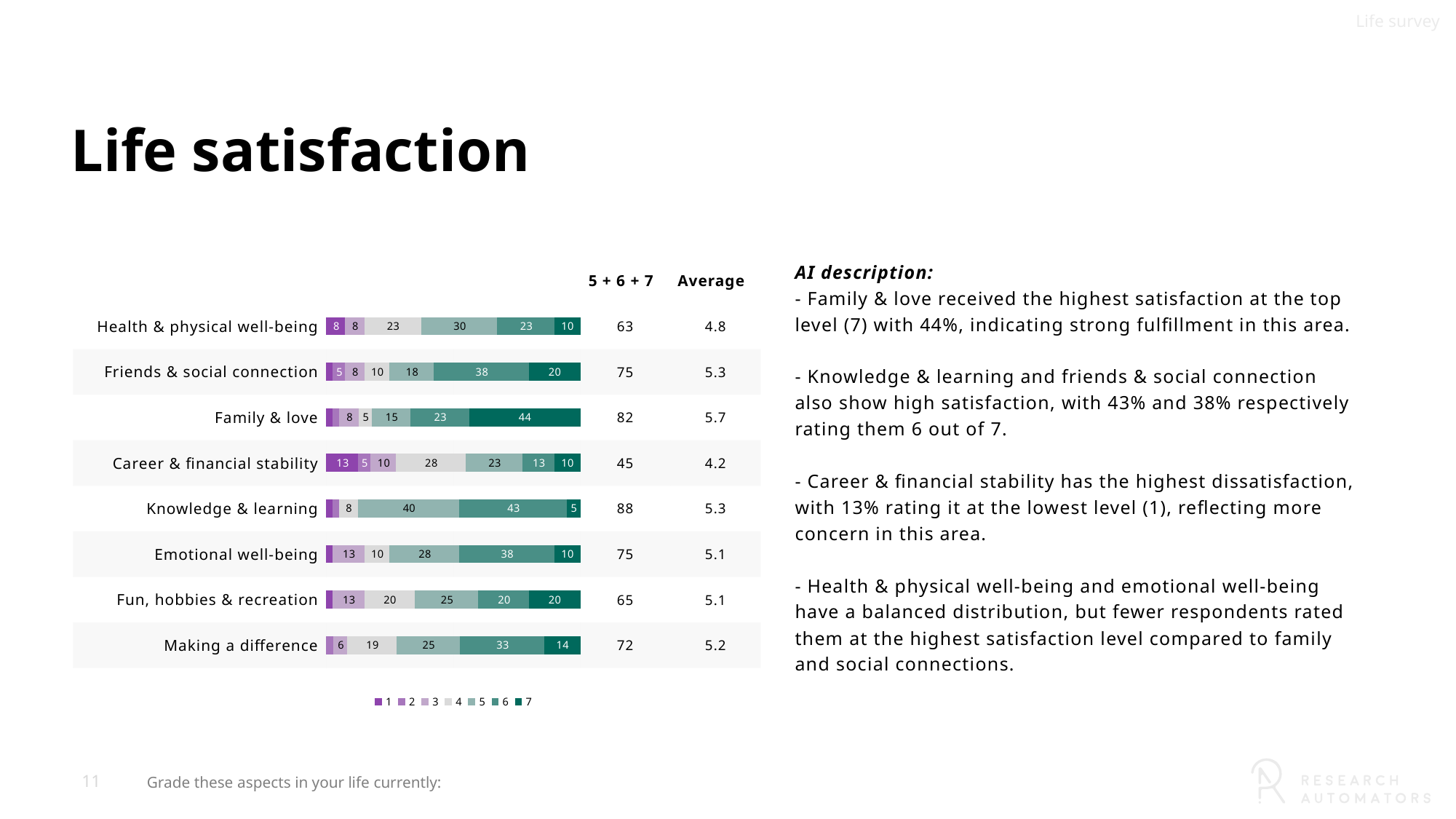
What is the difference between the series 7 value for Family & love and the series 7 value for Health & physical well-being? 34 How many series does the chart legend list? 7 Which is larger: the series 7 value for Fun, hobbies & recreation or the series 7 value for Making a difference? Fun, hobbies & recreation What is the value of series 7 for Family & love? 44 What is the value of series 1 for Career & financial stability? 13 How many categories (life aspects) are plotted in the chart? 8 What is the value of series 6 for Knowledge & learning? 43 What is the value of series 4 for Health & physical well-being? 23 What kind of chart is shown on the slide? Stacked bar chart What is the Average value shown for Family & love? 5.7 Which category has the highest 5 + 6 + 7 value? Knowledge & learning Which category has the lowest Average value? Career & financial stability